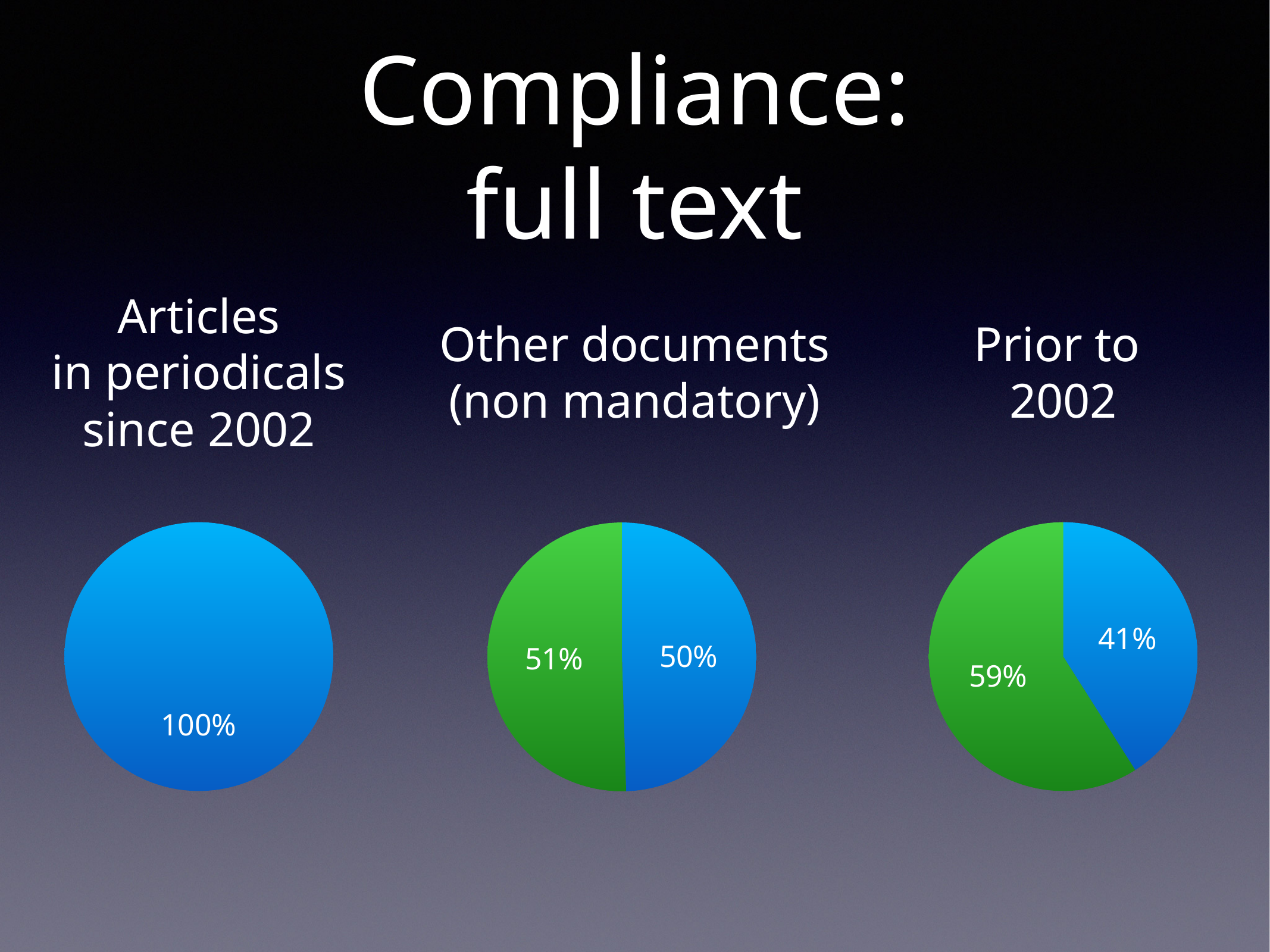
In the 'Other documents (non mandatory)' pie chart, what value is shown for the blue slice? 50% In the 'Prior to 2002' pie chart, which slice is larger, the green one or the blue one? Green In the 'Prior to 2002' pie chart, what value is shown for the blue slice? 41% What is the title of the slide containing the three pie charts? Compliance: full text In the 'Articles in periodicals since 2002' pie chart, what value is shown for the blue slice? 100% How many slices does the 'Articles in periodicals since 2002' pie chart have? 1 How many pie charts are on the slide? 3 In the 'Prior to 2002' pie chart, what value is shown for the green slice? 59% In the 'Prior to 2002' pie chart, what is the difference between the green slice and the blue slice? 18% What kind of charts are shown on the slide? Pie charts In the 'Other documents (non mandatory)' pie chart, what value is shown for the green slice? 51% How many slices does the 'Prior to 2002' pie chart have? 2